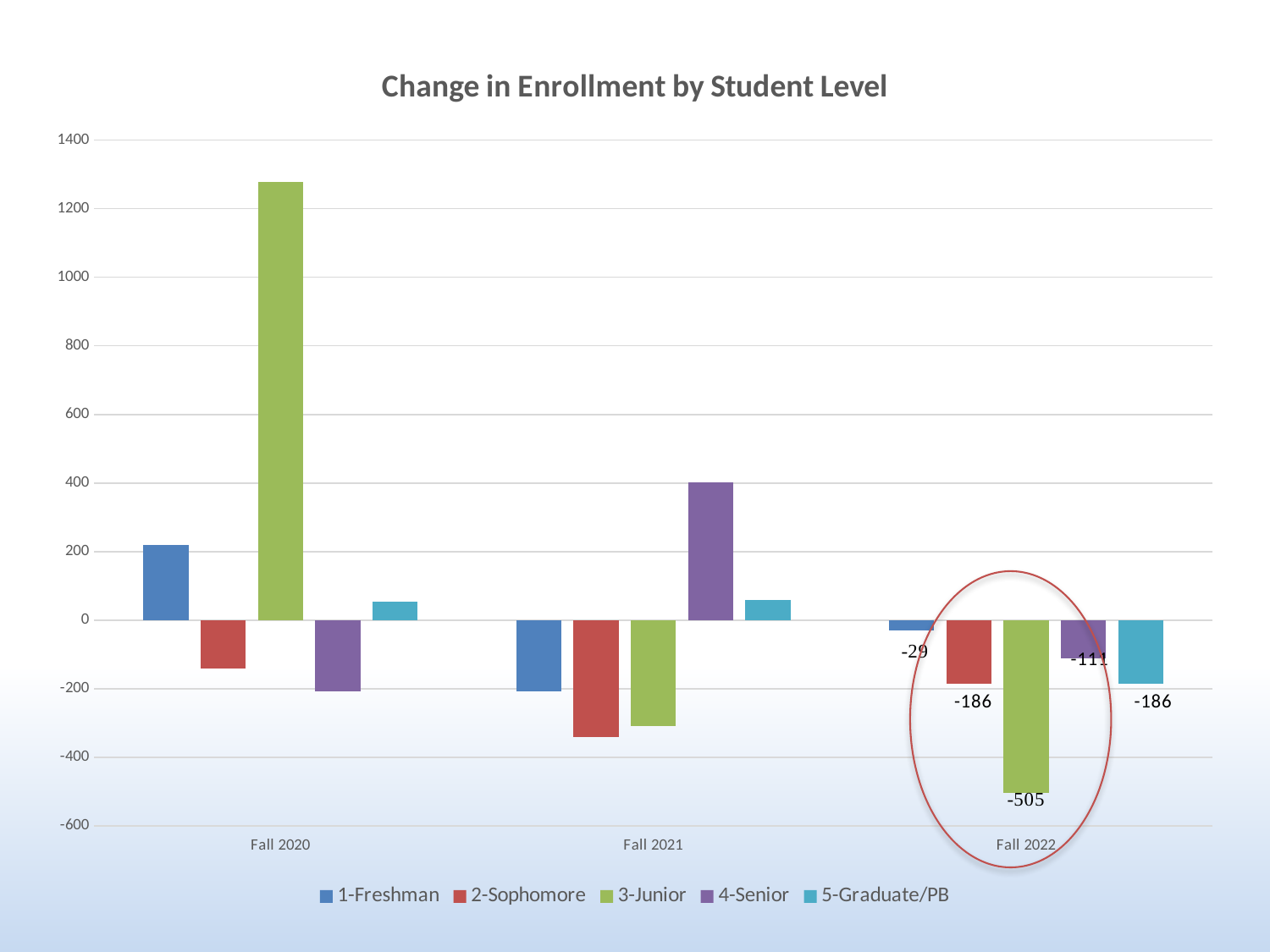
What is the value for 3-Junior in Fall 2022? -505 What is the value for 5-Graduate/PB in Fall 2022? -186 Is the value for 3-Junior in Fall 2020 greater or less than 1200? greater What is the value for 4-Senior in Fall 2022? -111 Is the value for 4-Senior in Fall 2021 greater or less than 200? greater How many series does the legend list? 5 What kind of chart is shown on the slide? Bar chart How many terms are shown on the x axis? 3 What is the difference between the 3-Junior and 2-Sophomore values in Fall 2022? 319 Which student level has the highest value in Fall 2020? 3-Junior Which student level has the lowest value in Fall 2022? 3-Junior What is the value for 1-Freshman in Fall 2022? -29